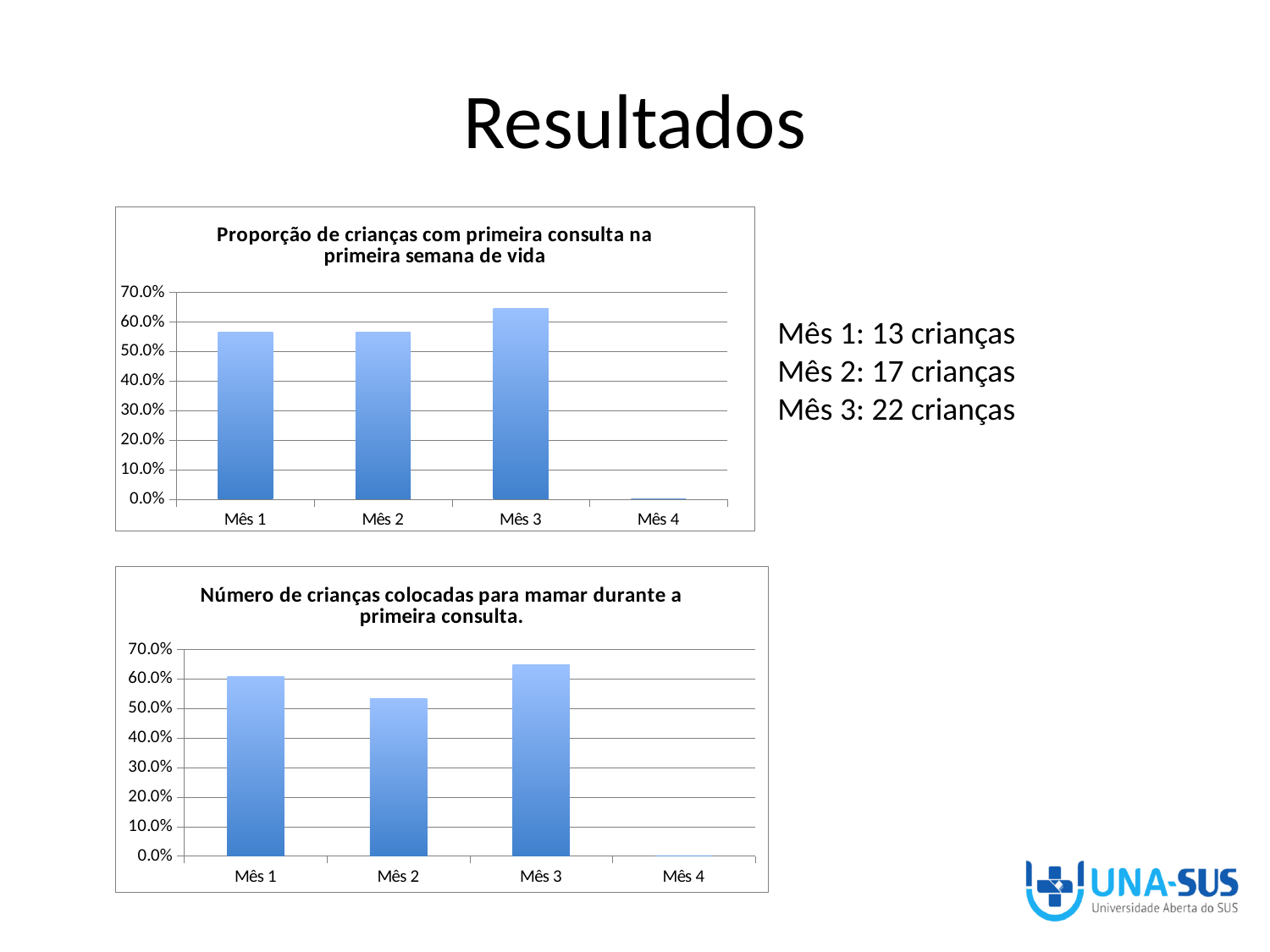
What is the title of the top chart on the slide? Proporção de crianças com primeira consulta na primeira semana de vida In the top chart, 'Proporção de crianças com primeira consulta na primeira semana de vida', which is larger, the value for Mês 3 or the value for Mês 2? Mês 3 What kind of chart is the top chart, 'Proporção de crianças com primeira consulta na primeira semana de vida'? bar chart In the bottom chart, 'Número de crianças colocadas para mamar durante a primeira consulta.', which is larger, the value for Mês 1 or the value for Mês 2? Mês 1 In the bottom chart, 'Número de crianças colocadas para mamar durante a primeira consulta.', is the value for Mês 3 greater or less than 60.0%? greater In the bottom chart, 'Número de crianças colocadas para mamar durante a primeira consulta.', which month has the highest value? Mês 3 In the top chart, 'Proporção de crianças com primeira consulta na primeira semana de vida', which month has the highest value? Mês 3 What kind of chart is the bottom chart, 'Número de crianças colocadas para mamar durante a primeira consulta.'? bar chart In the top chart, 'Proporção de crianças com primeira consulta na primeira semana de vida', is the value for Mês 1 greater or less than 60.0%? less In the top chart, 'Proporção de crianças com primeira consulta na primeira semana de vida', is the value for Mês 3 greater or less than 60.0%? greater In the top chart, 'Proporção de crianças com primeira consulta na primeira semana de vida', how many categories are shown on the x axis? 4